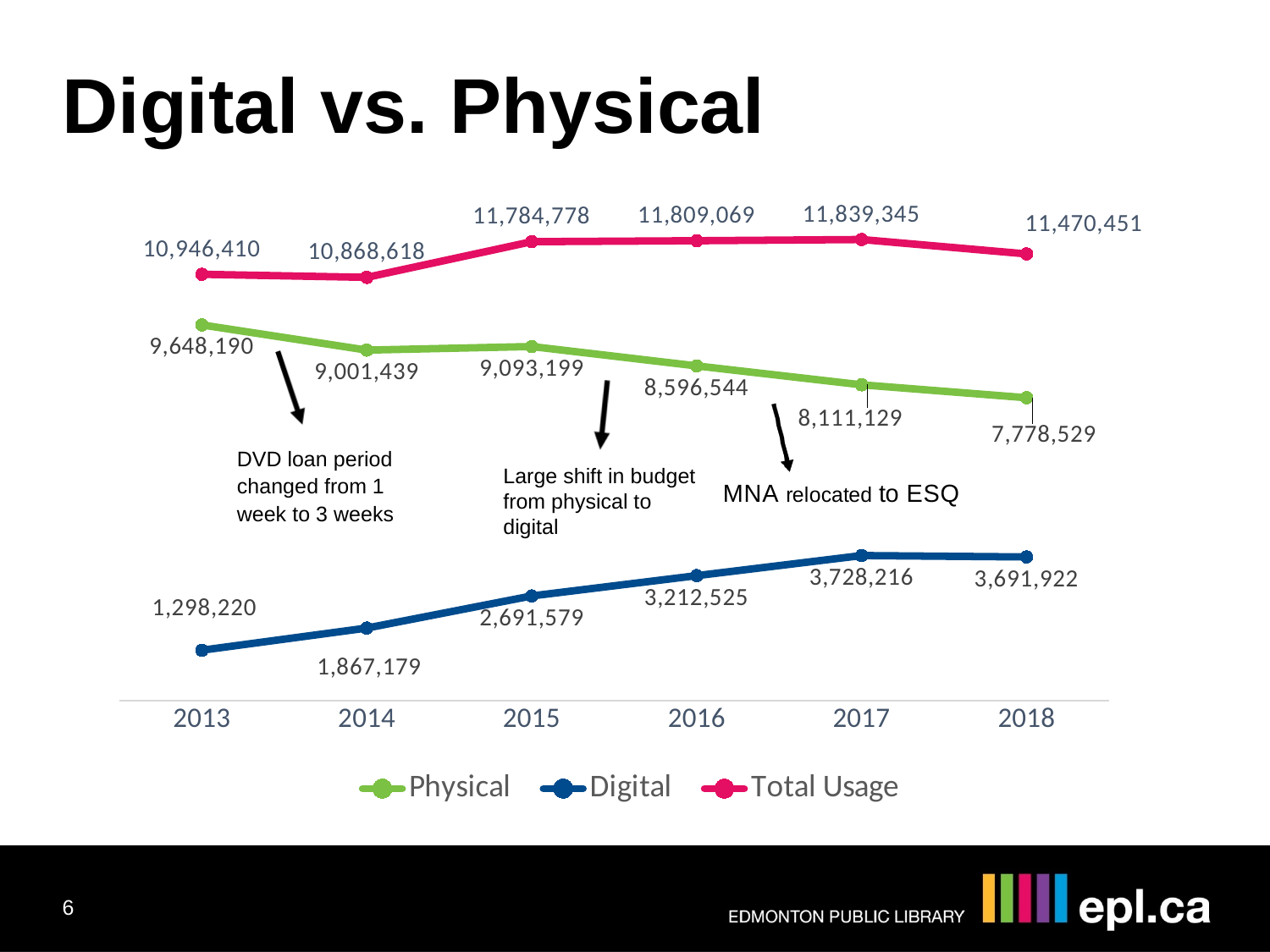
What is the Total Usage value for 2018? 11,470,451 In which year is the Physical series lowest? 2018 How many years are shown on the x axis? 6 What is the Digital value for 2016? 3,212,525 What kind of chart is shown on the slide? Line chart In which year is the Digital series highest? 2017 What is the difference between the Physical value in 2013 and in 2018? 1,869,661 In which year is Total Usage highest? 2017 How many series does the legend list? 3 Which is larger, the Digital value in 2017 or in 2018? 2017 What is the Physical value for 2013? 9,648,190 By how much did the Digital value increase from 2013 to 2017? 2,429,996